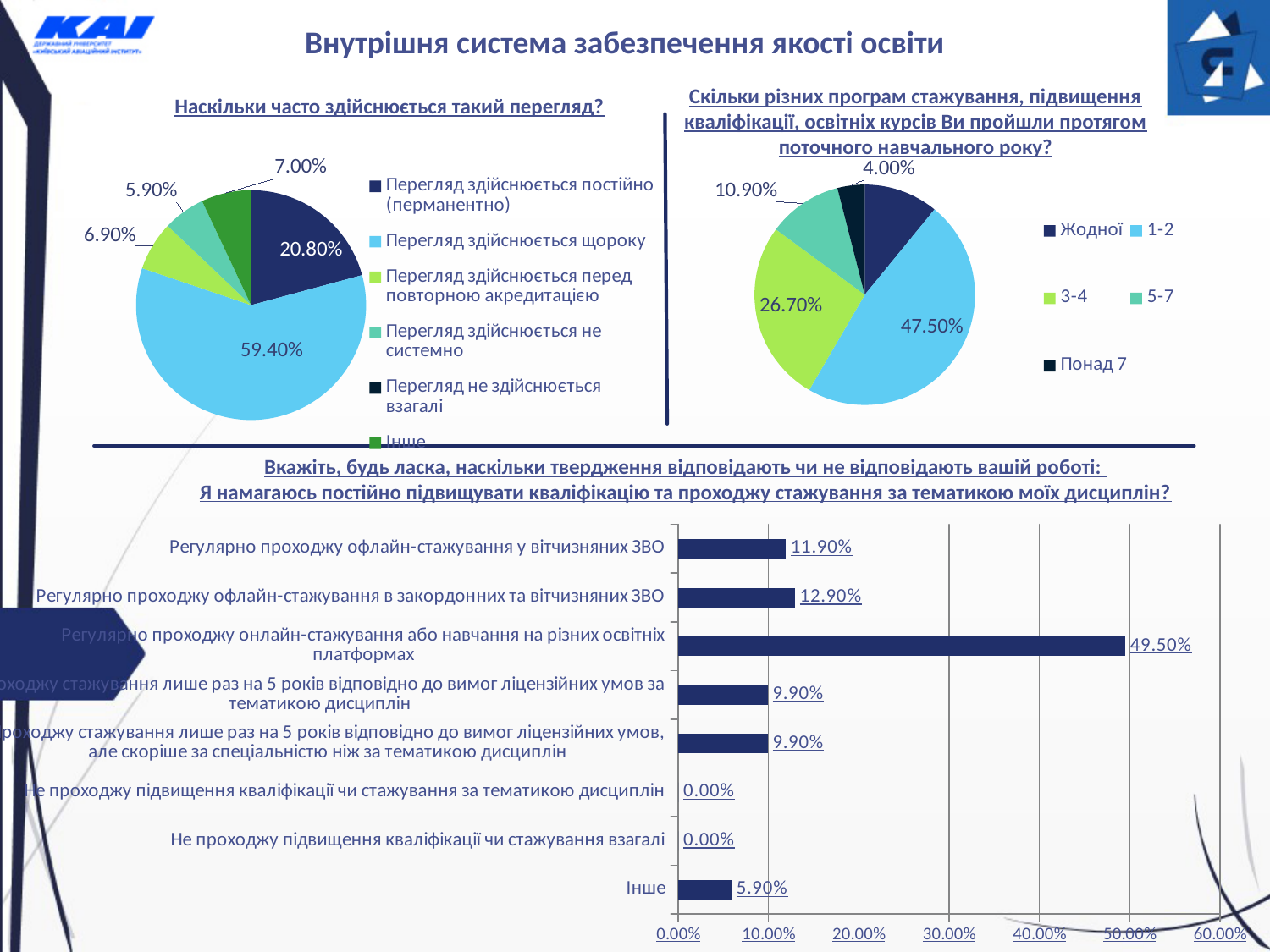
In the bottom bar chart, which is larger: the value for 'Регулярно проходжу офлайн-стажування у вітчизняних ЗВО' or the value for 'Інше'? Регулярно проходжу офлайн-стажування у вітчизняних ЗВО In the bottom bar chart, what is the value for 'Регулярно проходжу офлайн-стажування в закордонних та вітчизняних ЗВО'? 12.90% In the bottom bar chart, what is the highest value shown? 49.50% In the pie chart 'Наскільки часто здійснюється такий перегляд?', which category has the largest slice? Перегляд здійснюється щороку In the pie chart about the number of internship programs (top right), what share is shown for '3-4'? 26.70% What type of chart is the chart at the bottom of the slide? Bar chart In the pie chart 'Наскільки часто здійснюється такий перегляд?', what share is shown for 'Перегляд здійснюється постійно (перманентно)'? 20.80% In the pie chart 'Наскільки часто здійснюється такий перегляд?', what share is shown for 'Перегляд здійснюється щороку'? 59.40% In the pie chart 'Наскільки часто здійснюється такий перегляд?', what is the difference between the shares for 'Перегляд здійснюється щороку' and 'Перегляд здійснюється постійно (перманентно)'? 38.60% In the pie chart about the number of internship programs (top right), how many entries does the legend list? 5 In the pie chart about the number of internship programs (top right), what share is shown for 'Понад 7'? 4.00% In the pie chart about the number of internship programs (top right), what share is shown for '1-2'? 47.50%